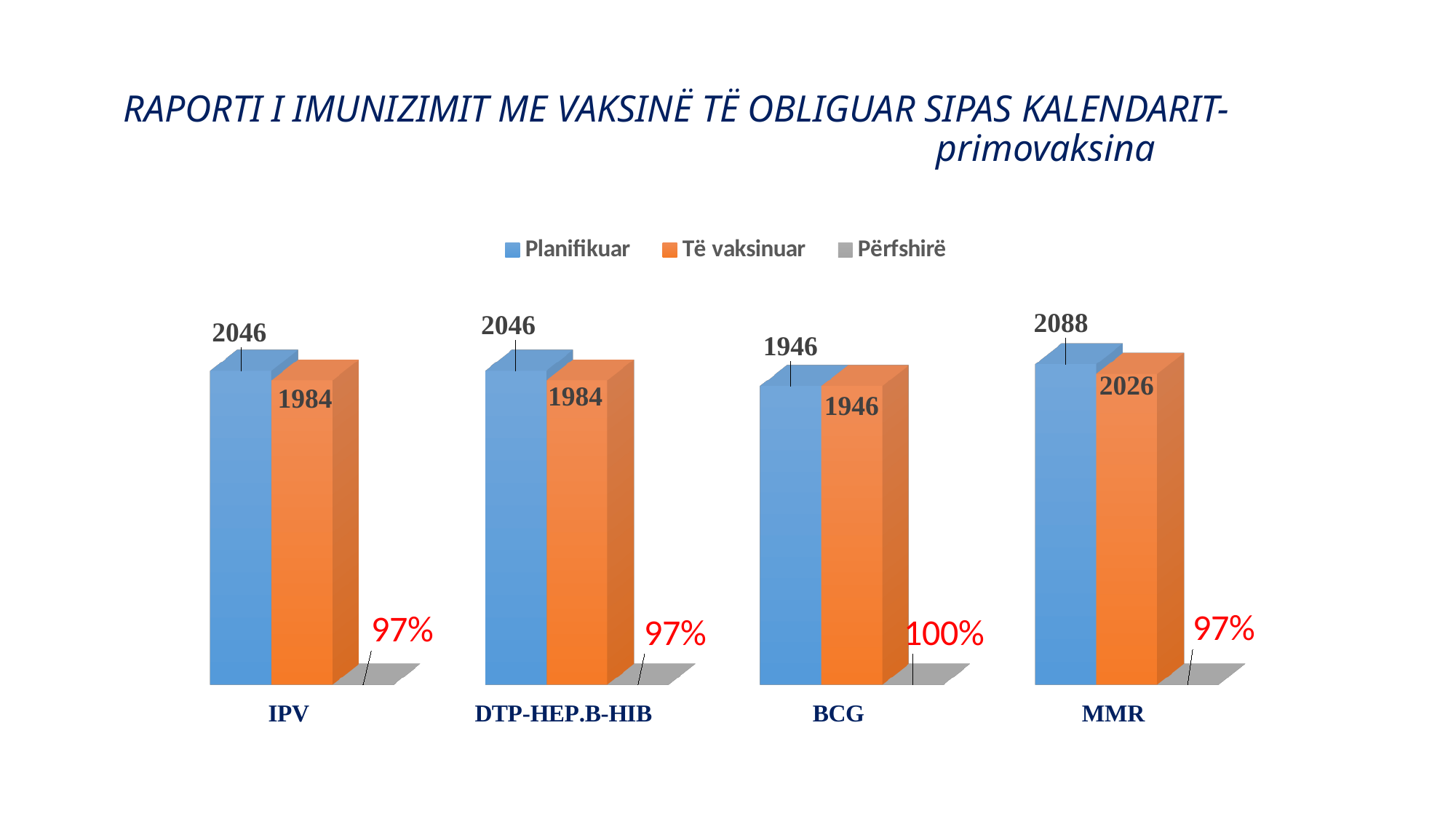
Which category has the lowest Planifikuar value? BCG Which is larger for DTP-HEP.B-HIB, the Planifikuar value or the Të vaksinuar value? Planifikuar How many vaccine categories are shown on the x axis? 4 What is the Të vaksinuar value for MMR? 2026 What is the Të vaksinuar value for BCG? 1946 What is the difference between the Planifikuar and Të vaksinuar values for MMR? 62 What kind of chart is shown on the slide? Bar chart What is the difference between the Planifikuar and Të vaksinuar values for IPV? 62 What is the Përfshirë percentage shown for BCG? 100% Which category has the highest Planifikuar value? MMR What is the Planifikuar value for IPV? 2046 How many series does the legend list? 3